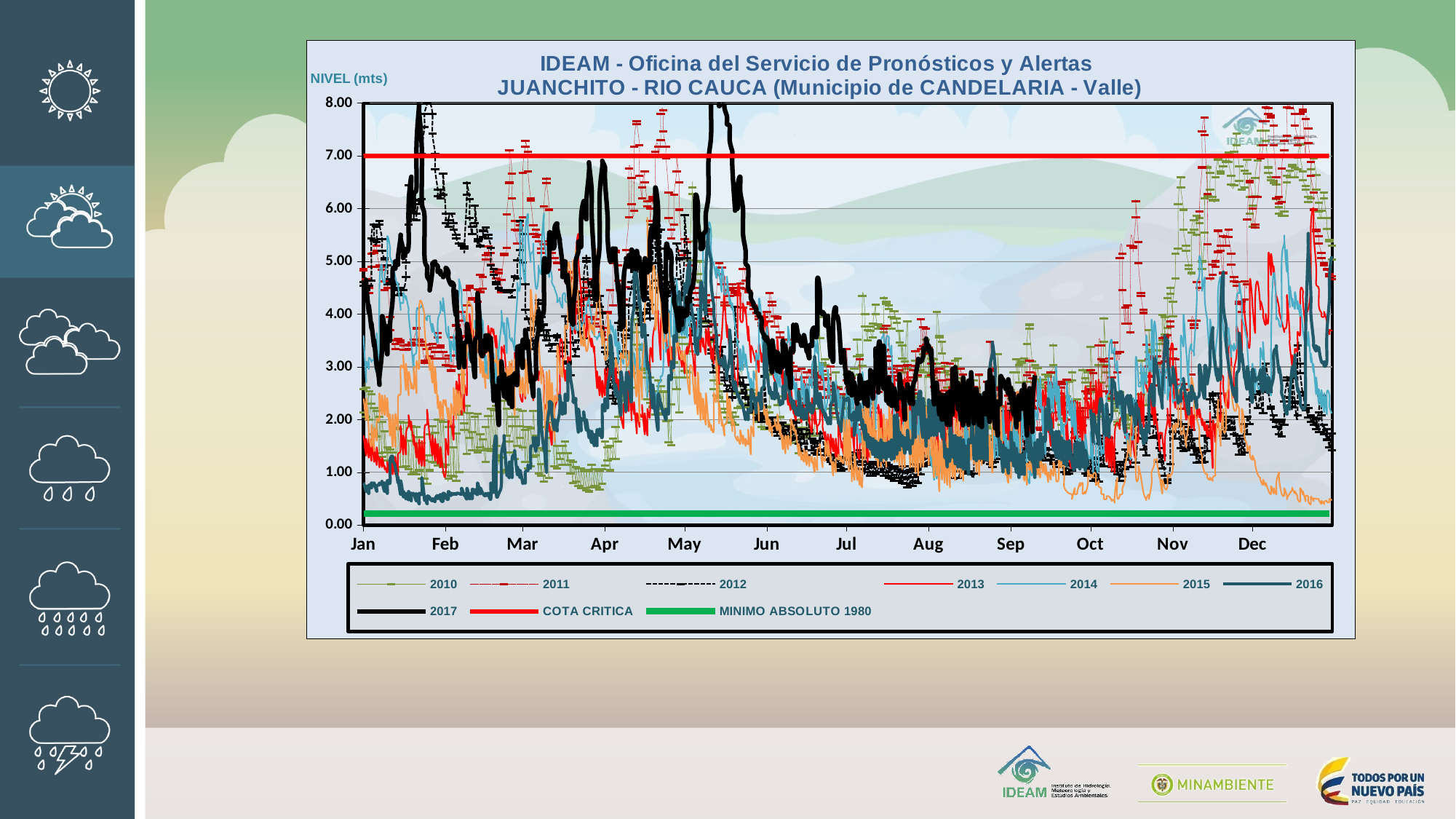
At what level (mts) is the COTA CRITICA line drawn? 7.00 What colour is the MINIMO ABSOLUTO 1980 line? green Is the MINIMO ABSOLUTO 1980 line greater or less than 1.00? less How many series does the legend list? 10 Is the value of the 2016 series in January greater or less than 1.00? less Is the peak of the 2017 series in May greater or less than 7.00? greater What kind of chart is shown on the slide? line chart What is the label of the y axis? NIVEL (mts) How many months are labelled along the x axis? 12